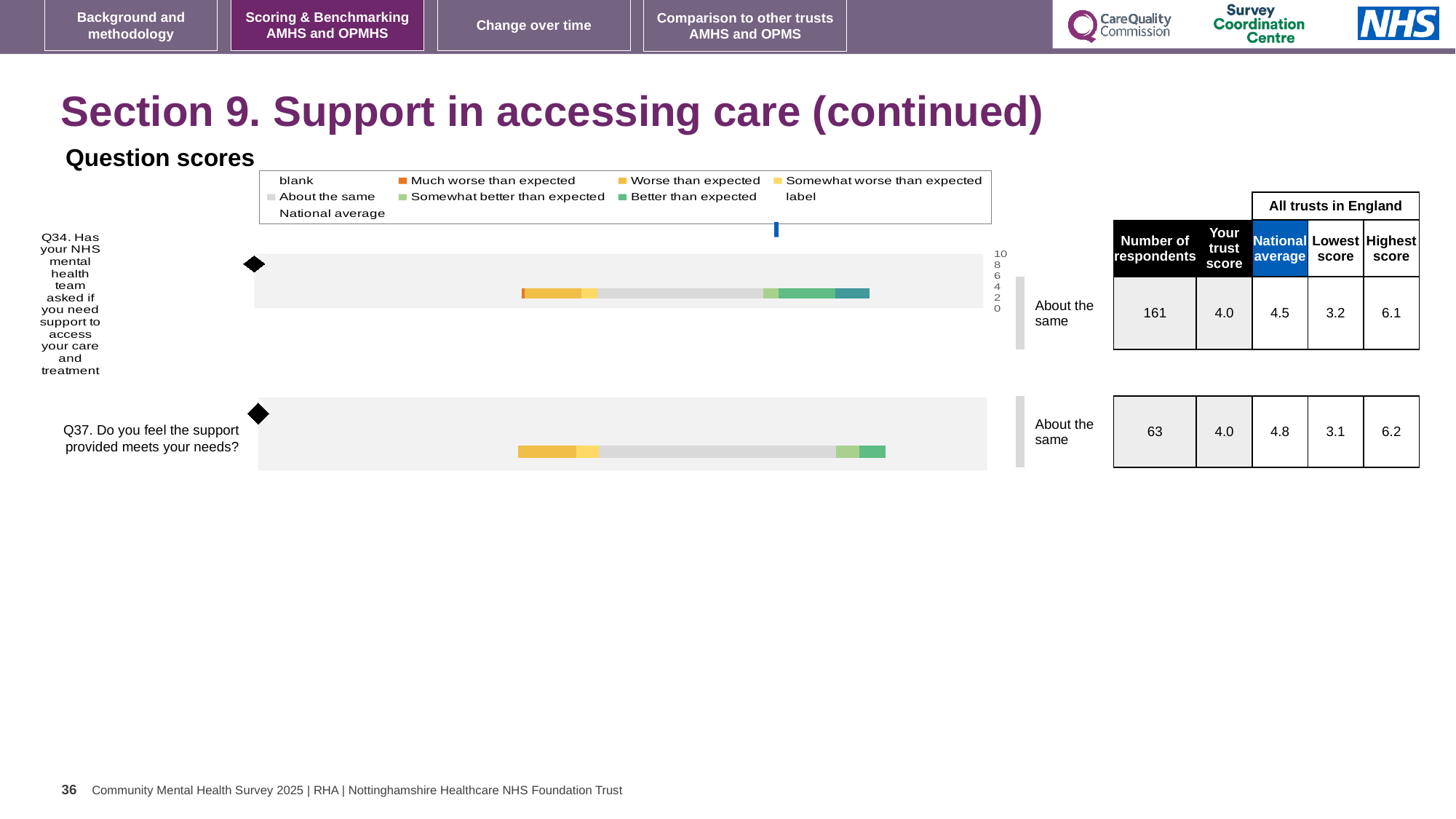
What is 'Your trust score' for Q37 in the table next to the chart? 4.0 How many more respondents answered Q34 than Q37? 98 Which question has the higher national average, Q34 or Q37? Q37 In the question scores chart, which benchmark category is shown for Q34 (Has your NHS mental health team asked if you need support to access your care and treatment)? About the same How many respondents are listed for Q34 in the table next to the chart? 161 In the question scores chart, which benchmark category is shown for Q37 (Do you feel the support provided meets your needs)? About the same How many questions are plotted in the question scores chart? 2 Which question has more respondents, Q34 or Q37? Q34 What kind of chart is used to show the question scores on this slide? bar chart What colour does the legend use for 'Much worse than expected'? orange What is the lowest score across all trusts in England for Q37? 3.1 What is the difference between the highest score and the lowest score for Q34? 2.9